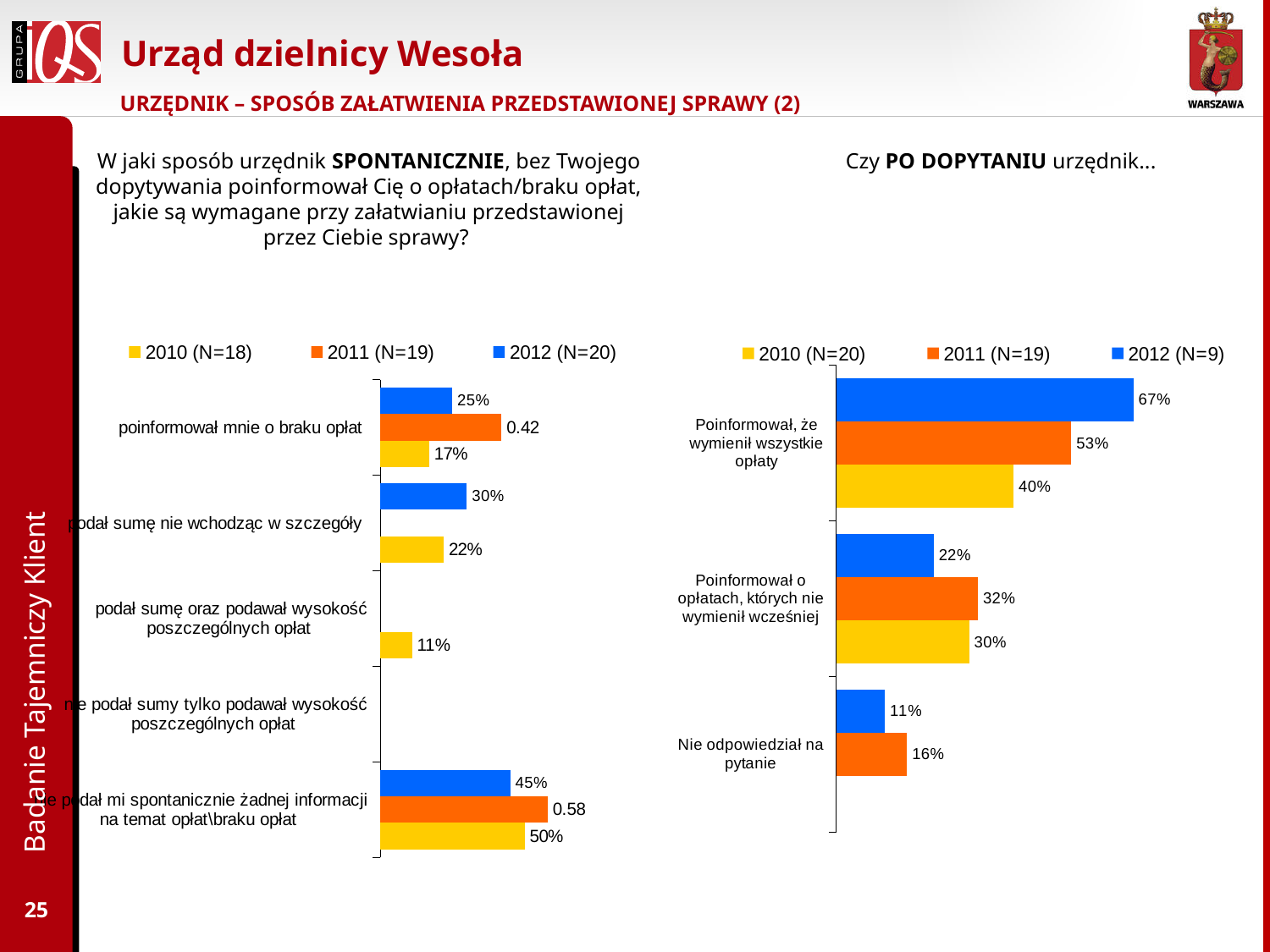
How many categories are shown on the left chart? 5 How many series does the legend of the right chart list? 3 In the left chart, what value is labelled on the 2011 (N=19) bar for "nie podał mi spontanicznie żadnej informacji na temat opłat\braku opłat"? 0.58 In the right chart, which year has the highest value for "Poinformował, że wymienił wszystkie opłaty"? 2012 (N=9) In the left chart, what is the 2012 (N=20) value for "poinformował mnie o braku opłat"? 25% In the right chart, which year has the lowest value for "Poinformował o opłatach, których nie wymienił wcześniej"? 2012 (N=9) In the right chart, what is the 2012 (N=9) value for "Poinformował, że wymienił wszystkie opłaty"? 67% What type of chart is the right chart? Bar chart In the left chart, which is larger for "podał sumę nie wchodząc w szczegóły": the 2012 (N=20) value or the 2010 (N=18) value? 2012 (N=20) In the right chart, what is the difference between the 2012 (N=9) and 2010 (N=20) values for "Poinformował, że wymienił wszystkie opłaty"? 27% In the right chart, what is the 2011 (N=19) value for "Nie odpowiedział na pytanie"? 16% In the left chart, what is the 2010 (N=18) value for "nie podał mi spontanicznie żadnej informacji na temat opłat\braku opłat"? 50%